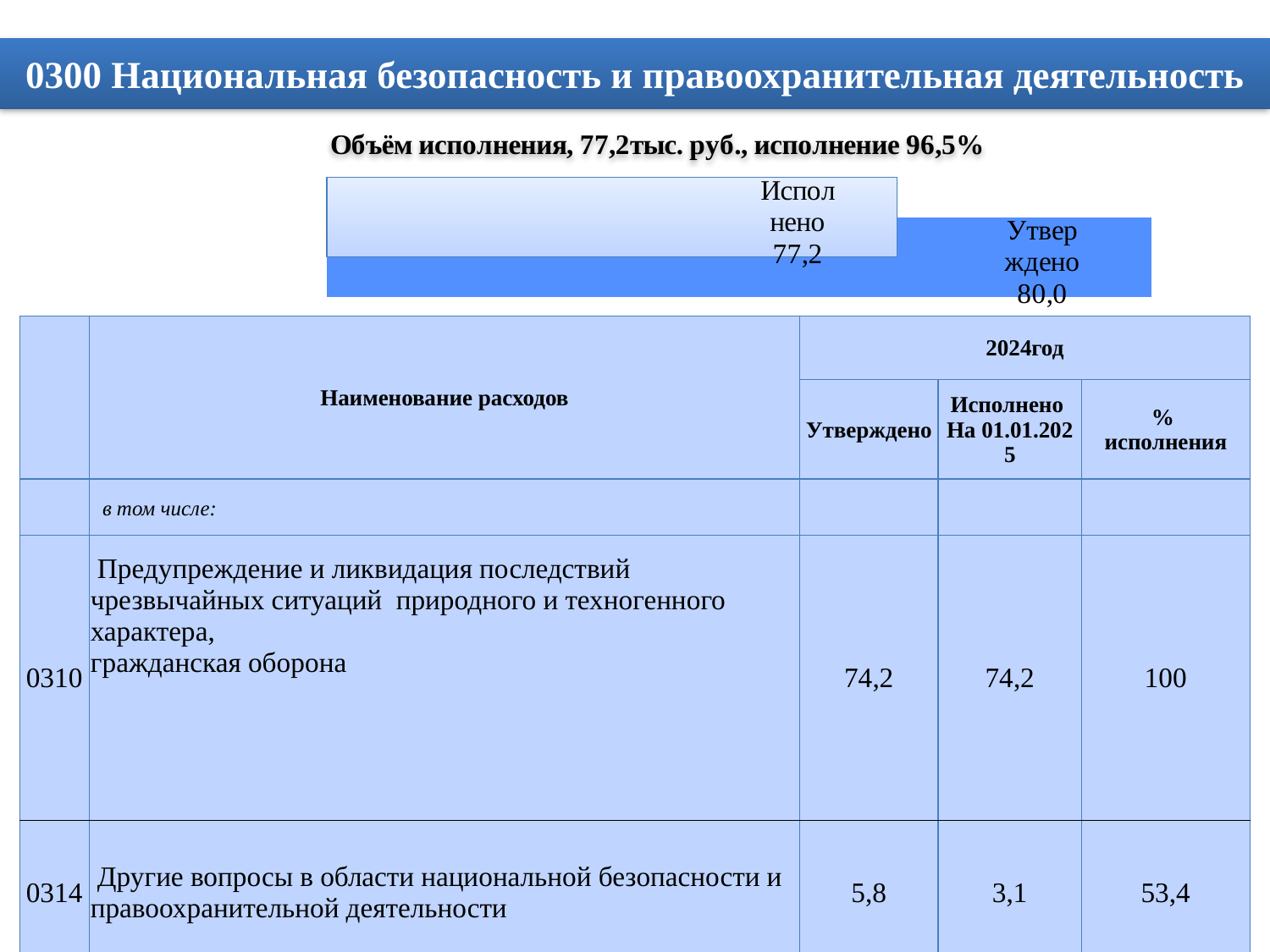
Which bar in the chart has the higher value, Исполнено or Утверждено? Утверждено What is the value of the bar labelled Исполнено in the chart? 77,2 Which bar in the chart has the highest value? Утверждено Which bar in the chart has the lowest value? Исполнено What is the title text printed directly above the chart? Объём исполнения, 77,2тыс. руб., исполнение 96,5% What is the value of the bar labelled Утверждено in the chart? 80,0 What kind of chart is shown above the table on the slide? bar chart What is the difference between the Утверждено and Исполнено values in the chart? 2,8 Are the bars in the chart horizontal or vertical? horizontal How many bars does the chart above the table show? 2